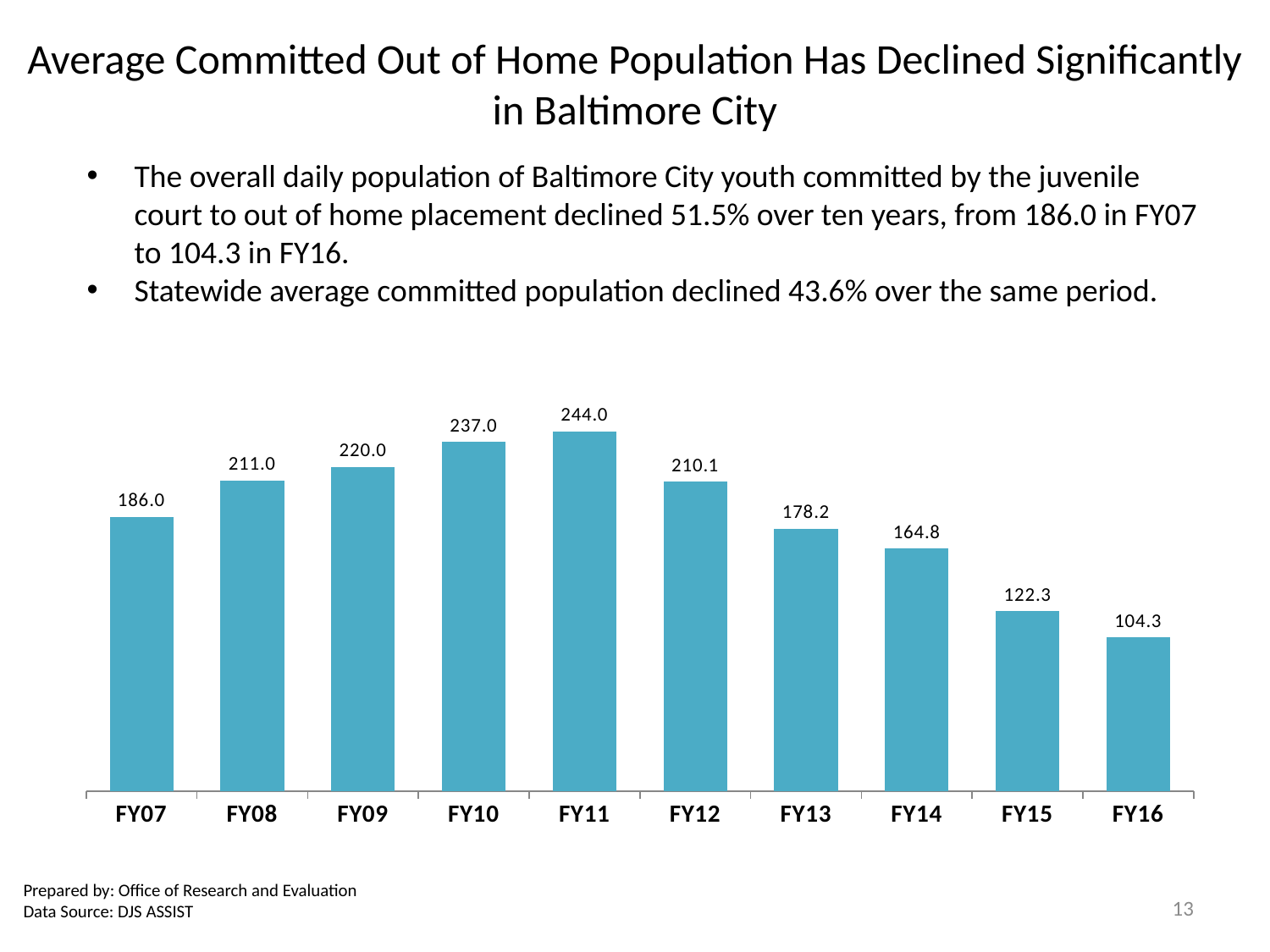
How many fiscal years are shown on the x axis? 10 What is the difference between the values for FY07 and FY16? 81.7 Which fiscal year has the highest value? FY11 Which fiscal year has the lowest value? FY16 Do the values rise or fall from FY11 to FY16? Fall What is the difference between the values for FY11 and FY12? 33.9 What is the value for FY13? 178.2 What kind of chart is shown on the slide? Bar chart Which is larger, the value for FY08 or the value for FY12? FY08 What is the value for FY07? 186.0 What is the value for FY16? 104.3 What is the value for FY11? 244.0